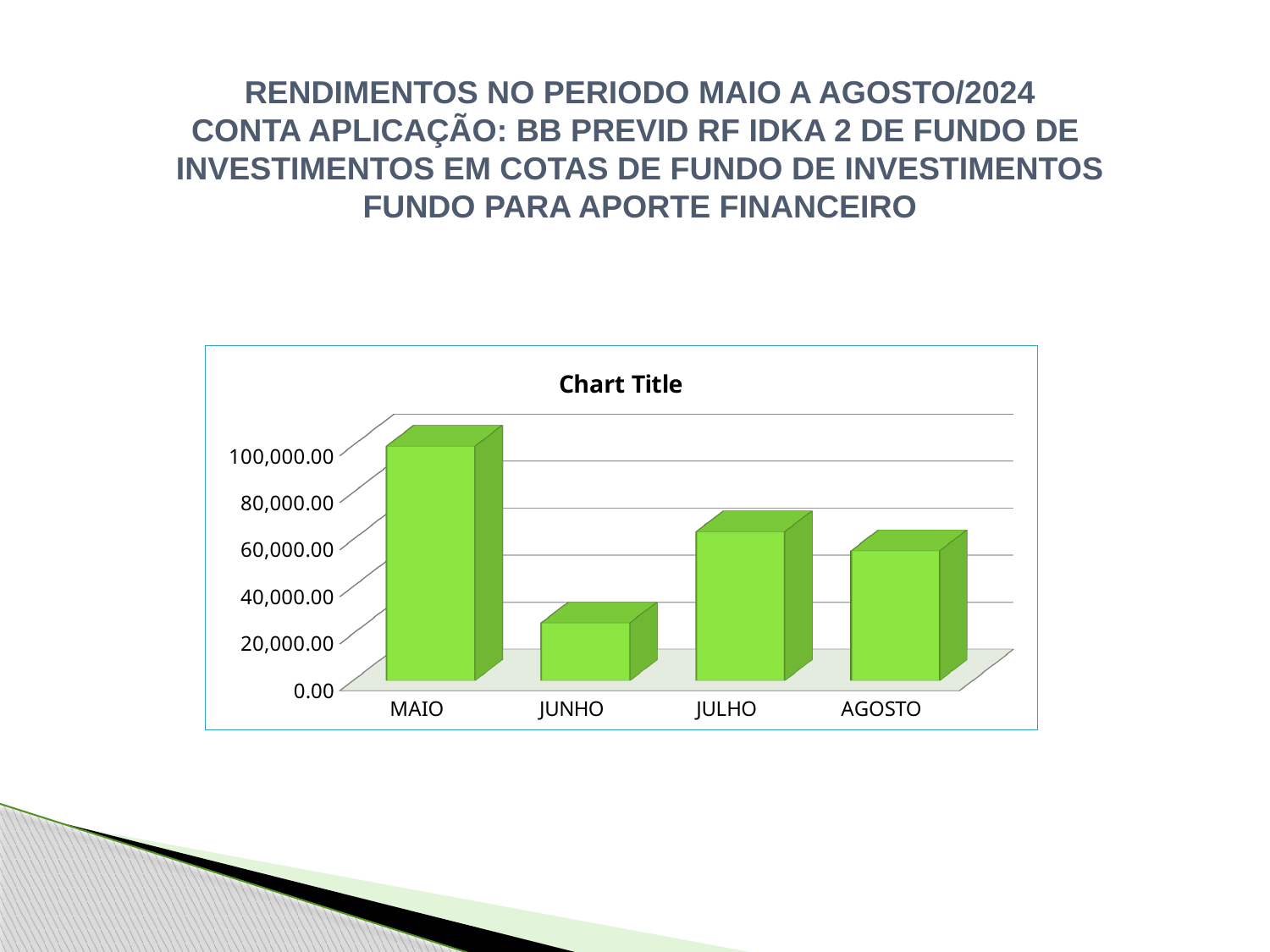
Is the value for AGOSTO greater or less than 80,000.00? less Which is larger, the value for MAIO or the value for AGOSTO? MAIO Which month has the highest value in the chart? MAIO What is the title shown above the chart? Chart Title Which is larger, the value for JUNHO or the value for JULHO? JULHO How many categories are shown on the x axis of the chart? 4 Which month has the lowest value in the chart? JUNHO Does the value rise or fall from MAIO to JUNHO? fall What kind of chart is shown on the slide? bar chart Is the value for JUNHO greater or less than 40,000.00? less Is the value for JULHO greater or less than 40,000.00? greater